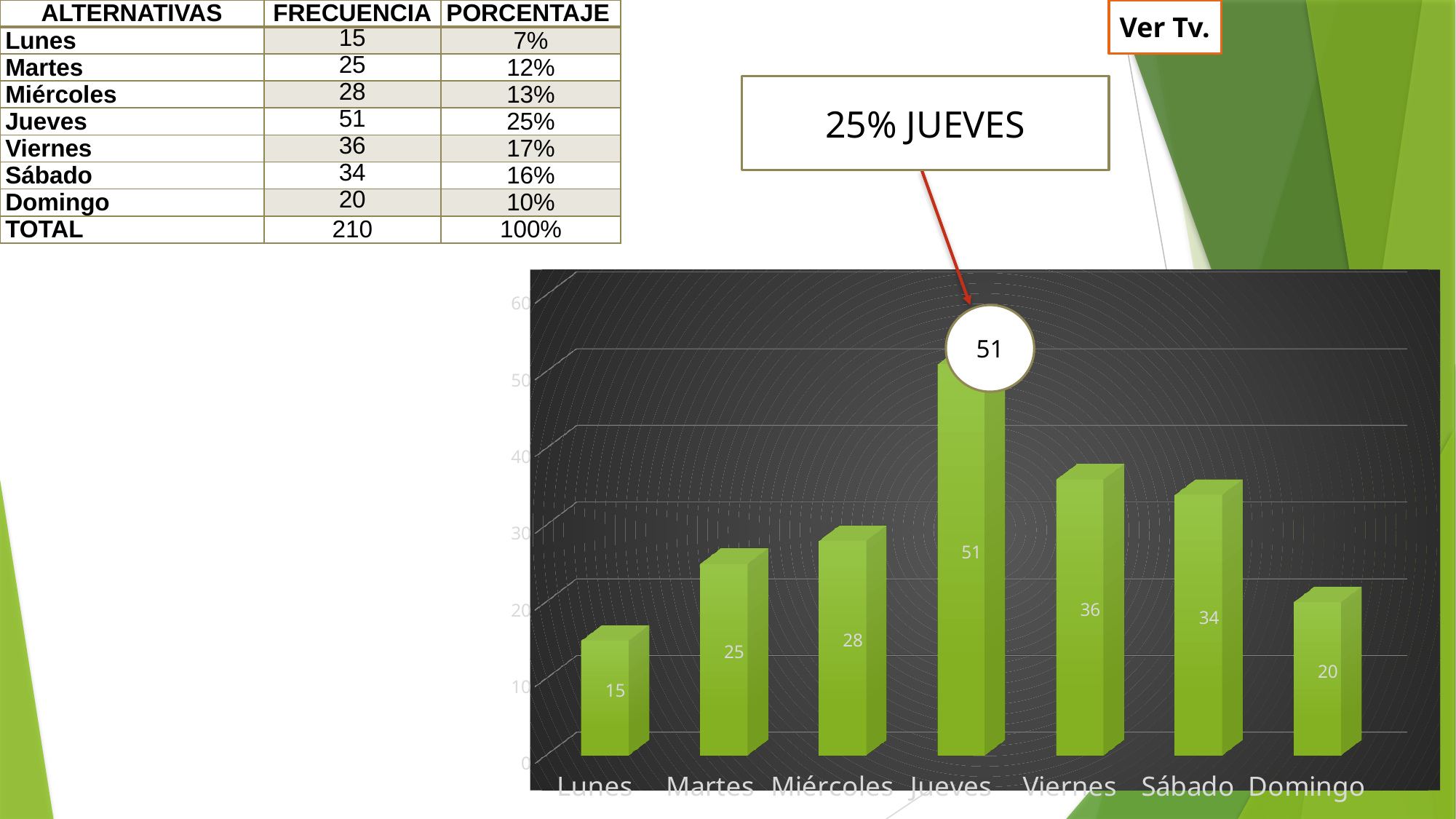
What is the value for Jueves in the chart? 51 What is the value for Lunes in the chart? 15 Which is larger, the value for Viernes or the value for Domingo? Viernes What is the difference between the values for Martes and Lunes? 10 How many days are shown on the x axis of the chart? 7 Which day has the highest value in the chart? Jueves What percentage does the callout box above the chart attribute to Jueves? 25% Is the value for Miércoles greater or less than 30? less What is the value for Sábado in the chart? 34 Which day has the lowest value in the chart? Lunes What kind of chart is shown on the slide? bar chart What is the difference between the values for Jueves and Viernes? 15